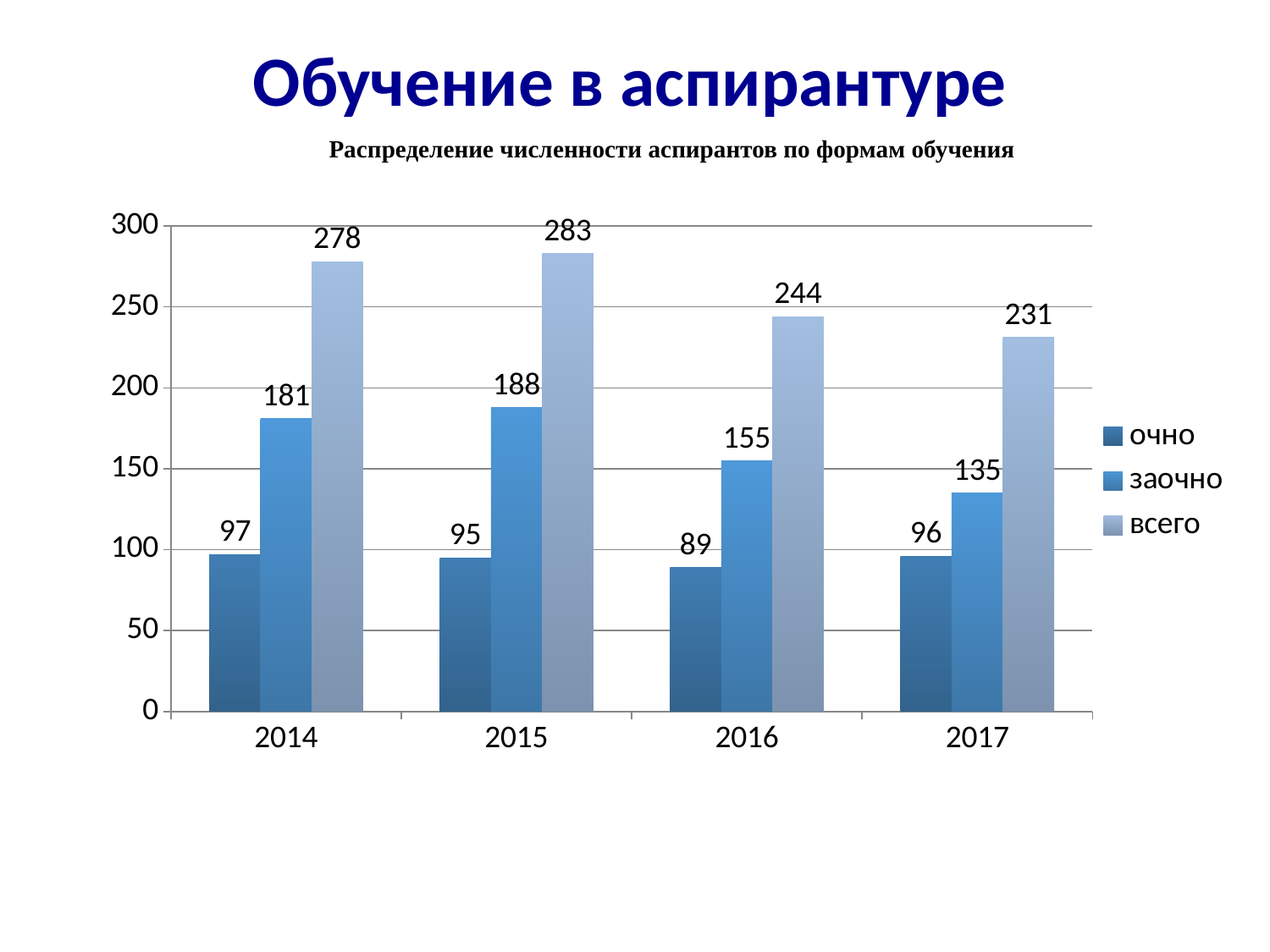
What is the title of the chart? Распределение численности аспирантов по формам обучения In which year is the очно value lowest? 2016 What is the value for всего in 2017? 231 What is the value for заочно in 2016? 155 In which year is the всего value highest? 2015 How many years are shown on the x axis? 4 What is the difference between the заочно values for 2015 and 2017? 53 How many series does the legend list? 3 Which is larger, the всего value for 2014 or for 2016? 2014 Does the заочно value rise or fall from 2015 to 2017? fall What kind of chart is this? bar chart What is the value for очно in 2014? 97